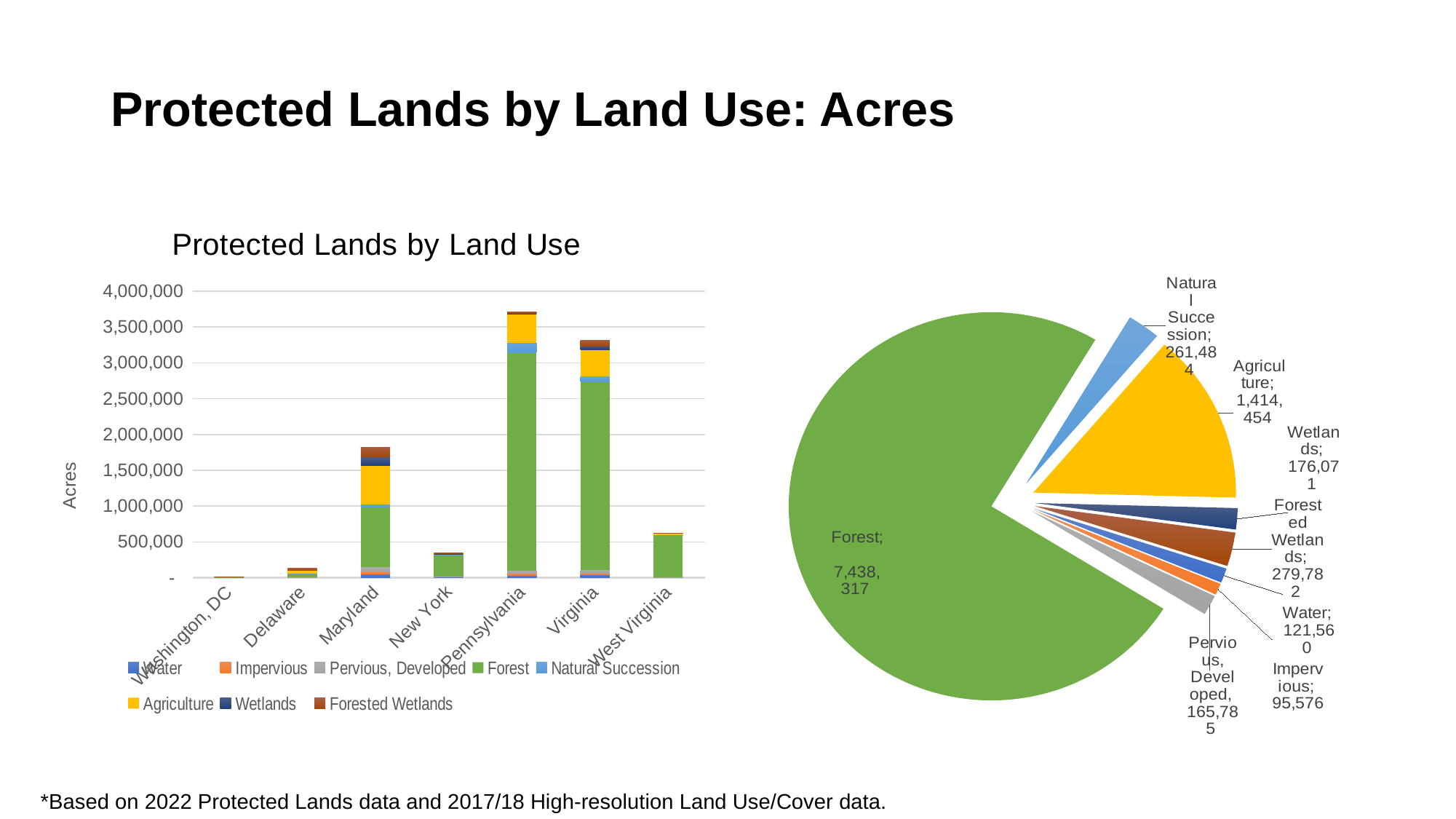
In the pie chart on the right, what is the difference between the Agriculture and Natural Succession values? 1,152,970 What type of chart is the 'Protected Lands by Land Use' chart on the left? Stacked bar chart In the pie chart on the right, what is the value for Agriculture? 1,414,454 In the 'Protected Lands by Land Use' bar chart, is the total for Virginia greater or less than 3,000,000? greater In the pie chart on the right, which land use has the smallest slice? Impervious In the pie chart on the right, what is the value for Forest? 7,438,317 In the 'Protected Lands by Land Use' bar chart, is the total for Maryland greater or less than 2,000,000? less In the pie chart on the right, how many slices are there? 8 How many series does the legend of the 'Protected Lands by Land Use' bar chart list? 8 In the pie chart on the right, which is larger: Water or Impervious? Water In the 'Protected Lands by Land Use' bar chart, which state has the tallest stacked bar? Pennsylvania In the pie chart on the right, what is the value for Forested Wetlands? 279,782